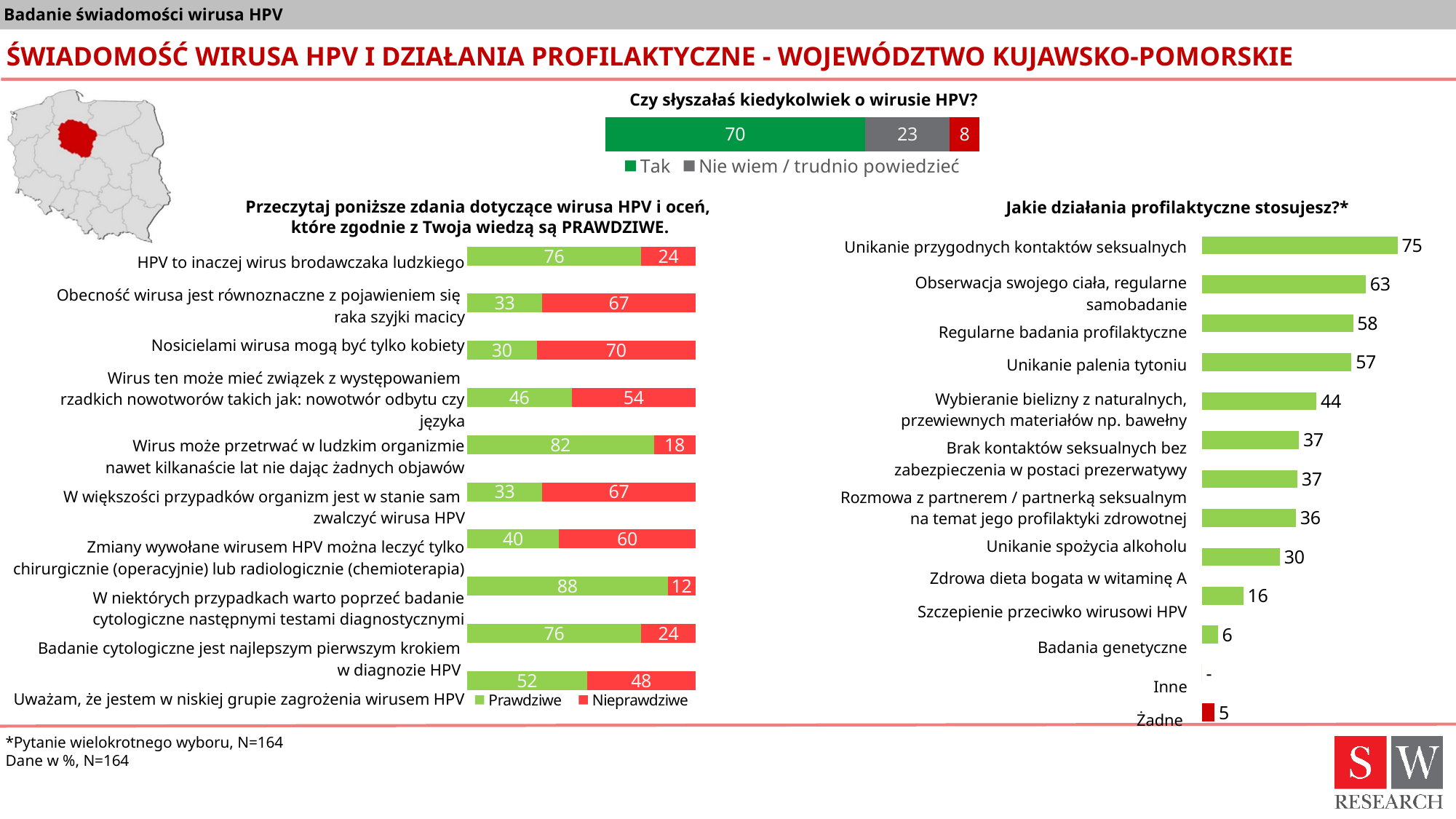
In the chart 'Jakie działania profilaktyczne stosujesz?*', what is the value for 'Unikanie palenia tytoniu'? 57 In the chart 'Czy słyszałaś kiedykolwiek o wirusie HPV?', what is the value for 'Nie wiem / trudno powiedzieć'? 23 In the chart 'Przeczytaj poniższe zdania dotyczące wirusa HPV...', what is the 'Nieprawdziwe' value for 'Nosicielami wirusa mogą być tylko kobiety'? 70 In the chart 'Jakie działania profilaktyczne stosujesz?*', which category has the highest value? Unikanie przygodnych kontaktów seksualnych In the chart 'Jakie działania profilaktyczne stosujesz?*', how many categories are shown? 13 In the chart 'Jakie działania profilaktyczne stosujesz?*', what is the value for 'Szczepienie przeciwko wirusowi HPV'? 16 In the chart 'Przeczytaj poniższe zdania dotyczące wirusa HPV...', what is the 'Prawdziwe' value for 'Wirus może przetrwać w ludzkim organizmie nawet kilkanaście lat nie dając żadnych objawów'? 82 What type of chart is 'Jakie działania profilaktyczne stosujesz?*'? Bar chart In the chart 'Przeczytaj poniższe zdania dotyczące wirusa HPV...', how many series does the legend list? 2 In the chart 'Jakie działania profilaktyczne stosujesz?*', which is larger: 'Unikanie spożycia alkoholu' or 'Badania genetyczne'? Unikanie spożycia alkoholu In the chart 'Jakie działania profilaktyczne stosujesz?*', what is the difference between 'Unikanie przygodnych kontaktów seksualnych' and 'Regularne badania profilaktyczne'? 17 In the chart 'Czy słyszałaś kiedykolwiek o wirusie HPV?', what is the value for 'Tak'? 70